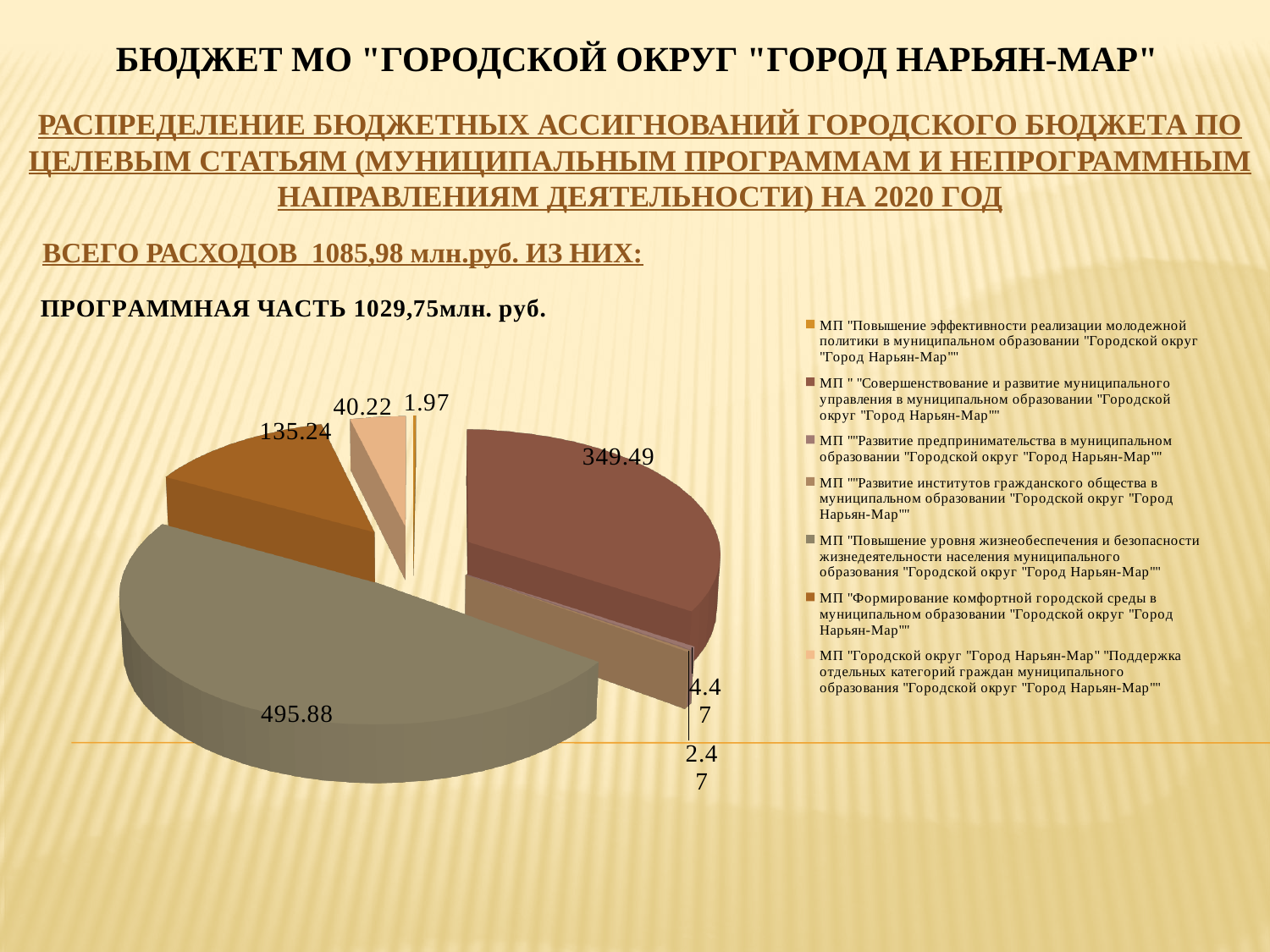
What is the value of the slice for МП "Совершенствование и развитие муниципального управления"? 349.49 What is the difference between the slices labelled 4.47 and 2.47? 2 What is the largest value shown on the pie chart? 495.88 What is the difference between the two largest slices, 495.88 and 349.49? 146.39 How many entries does the legend of the pie chart list? 7 What is the value of the slice for МП "Повышение уровня жизнеобеспечения и безопасности жизнедеятельности населения"? 495.88 What type of chart is shown on the slide? pie chart What is the value of the slice for МП "Формирование комфортной городской среды"? 135.24 What is the smallest value shown on the pie chart? 1.97 What total for the programme part (ПРОГРАММНАЯ ЧАСТЬ) is stated above the chart? 1029,75 млн. руб. How many slices does the pie chart have? 7 Which is larger: the slice labelled 135.24 or the slice labelled 40.22? 135.24